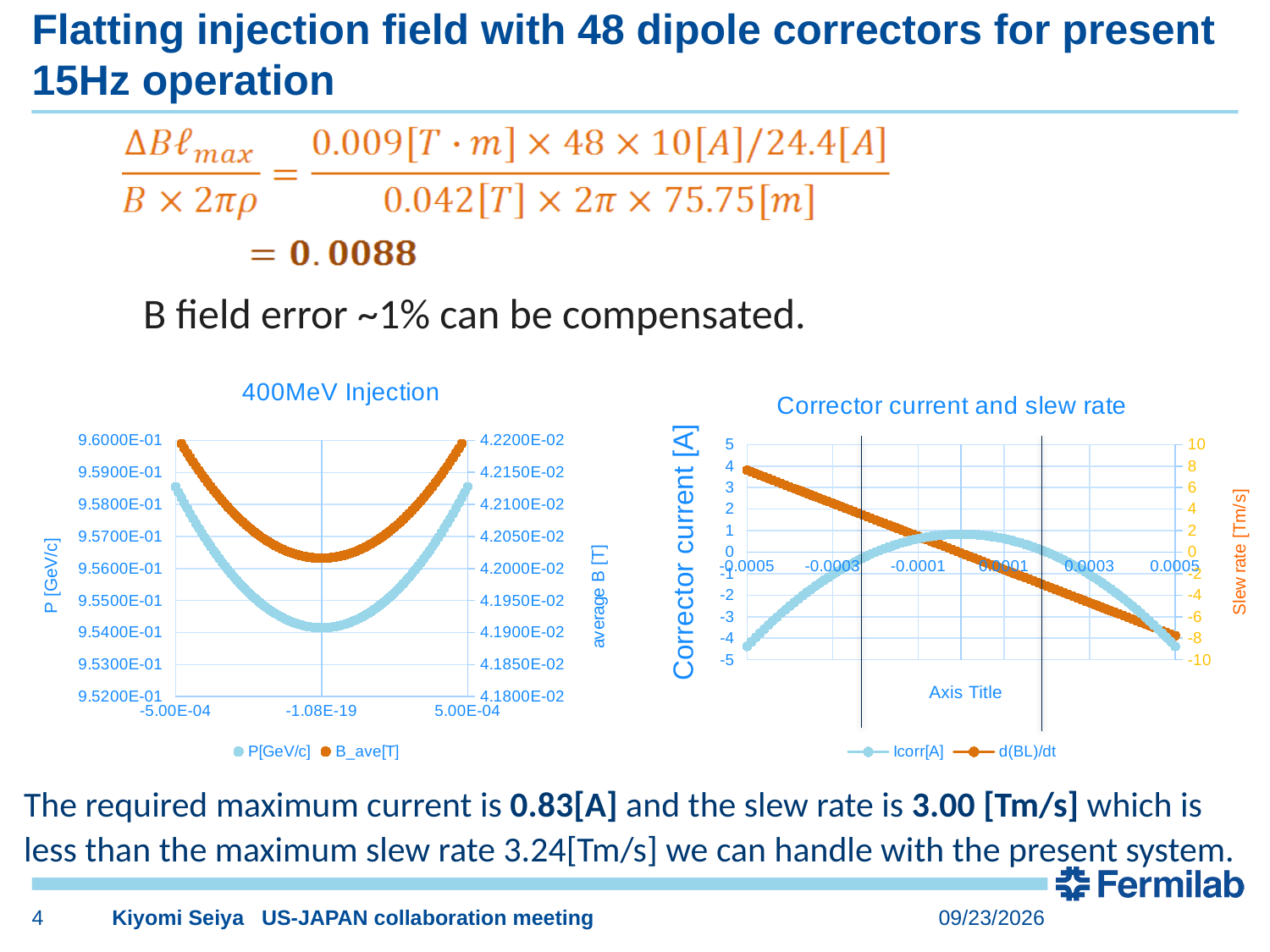
In the 400MeV Injection chart, does the P[GeV/c] series rise or fall as x goes from -5.00E-04 to -1.08E-19? fall In the Corrector current and slew rate chart, is the value of d(BL)/dt at x = -0.0005 greater or less than 4? greater In the 400MeV Injection chart, is the value of B_ave[T] at x = -5.00E-04 greater or less than 4.2150E-02? greater In the 400MeV Injection chart, is the value of P[GeV/c] at x = -1.08E-19 greater or less than 9.5500E-01? less What kind of chart is the 400MeV Injection chart? scatter chart In the Corrector current and slew rate chart, does the d(BL)/dt series rise or fall as x increases from -0.0005 to 0.0005? fall In the Corrector current and slew rate chart, how many series does the legend list? 2 What is the title of the chart on the left? 400MeV Injection In the Corrector current and slew rate chart, which series is plotted in orange? d(BL)/dt In the 400MeV Injection chart, how many series does the legend list? 2 What is the title of the chart on the right? Corrector current and slew rate